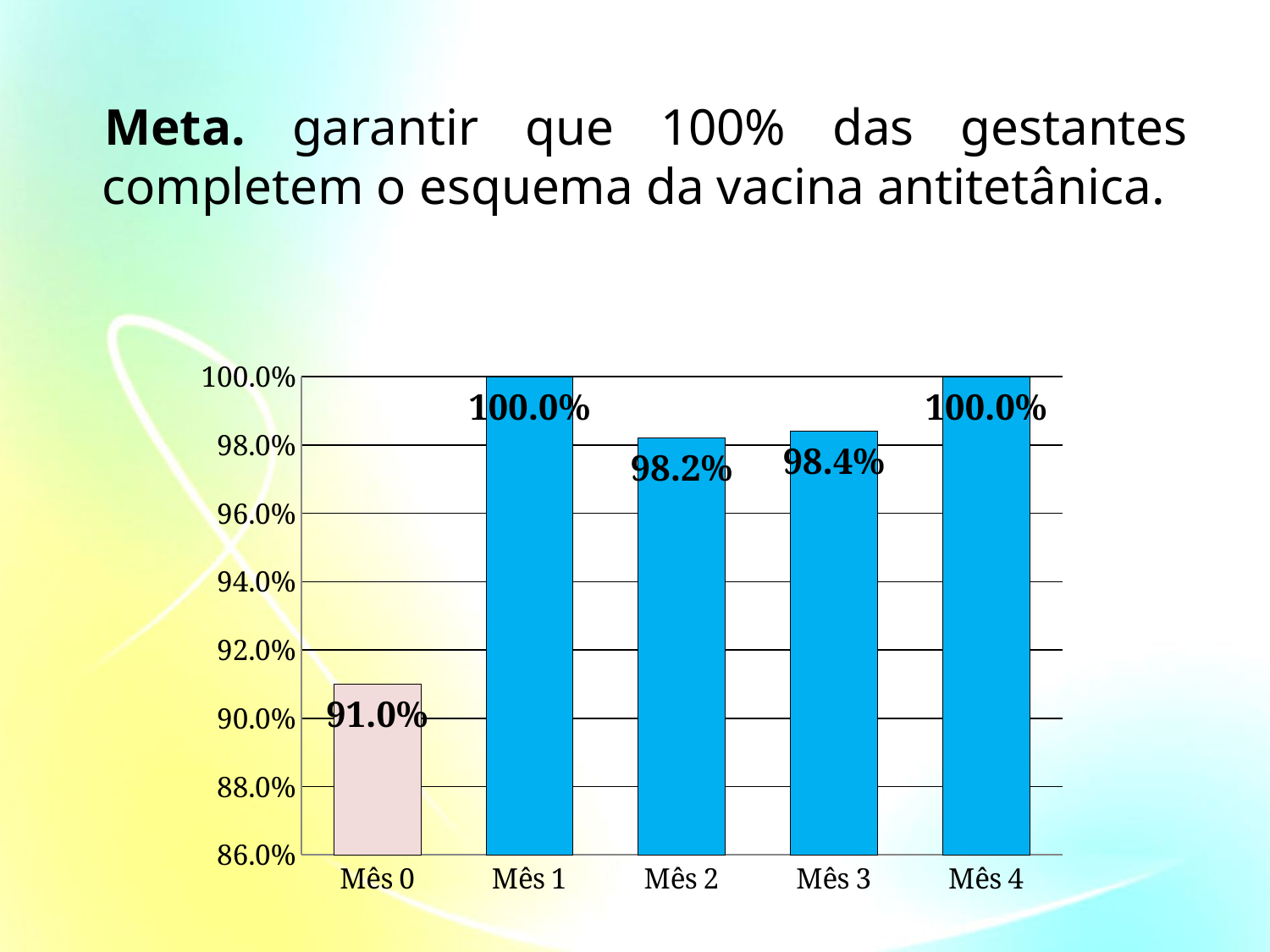
Which bar is shown in a different colour from the others? Mês 0 Is the value for Mês 0 greater or less than 92.0%? less What is the value for Mês 3? 98.4% What is the value for Mês 0? 91.0% How many categories are shown on the x axis? 5 What is the value for Mês 1? 100.0% Which category has the lowest value? Mês 0 What is the difference between the values for Mês 3 and Mês 2? 0.2% What is the difference between the values for Mês 1 and Mês 0? 9.0% What kind of chart is shown on the slide? bar chart What is the value for Mês 2? 98.2% Which is larger, the value for Mês 2 or the value for Mês 0? Mês 2